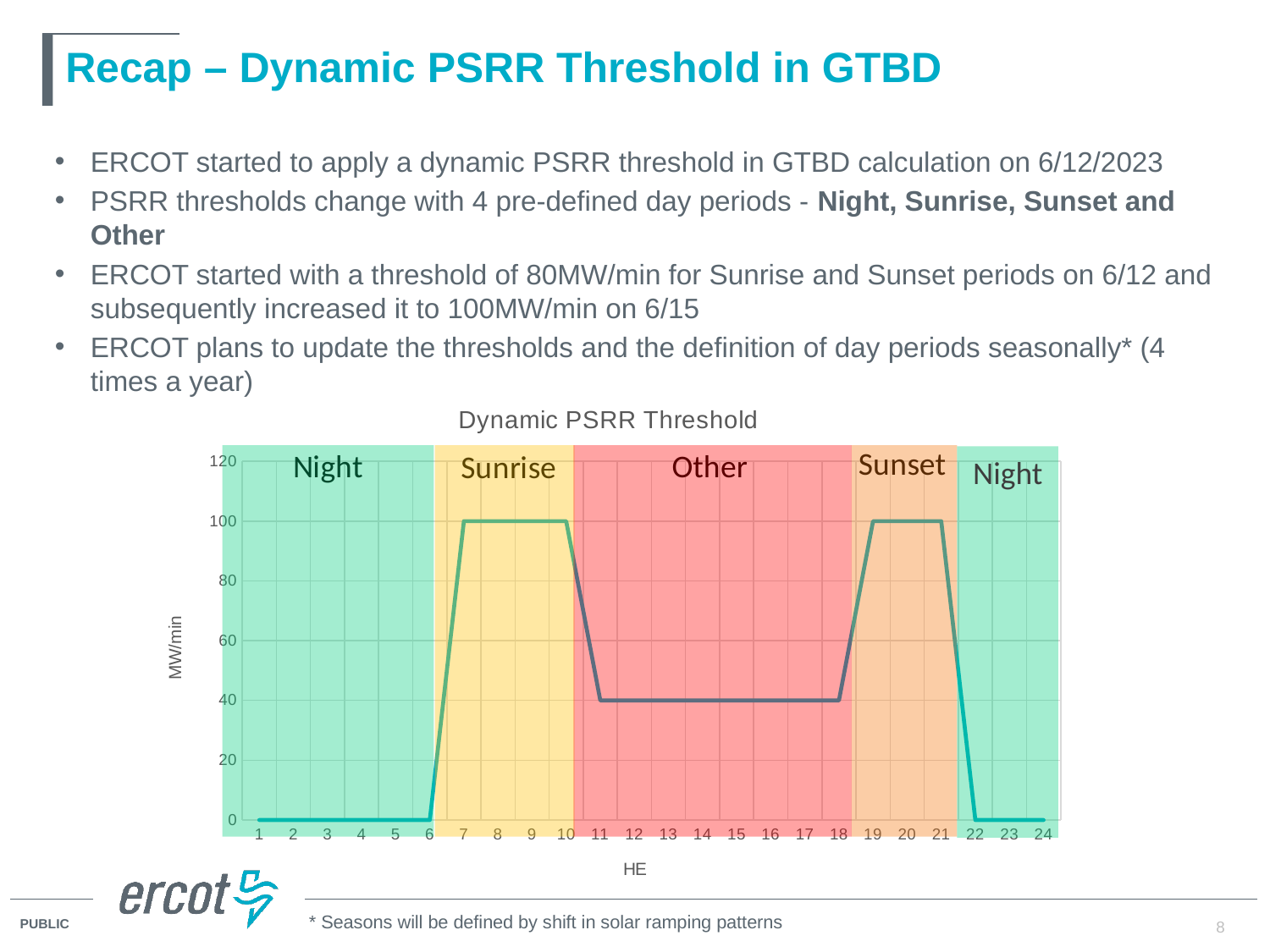
What is the threshold value in MW/min at HE 20? 100 Is the threshold value at HE 12 greater or less than 60? less What is the threshold value in MW/min at HE 8? 100 What kind of chart is shown on the slide? line chart What is the label of the y axis of the chart? MW/min What is the threshold value in MW/min at HE 3? 0 What is the difference in MW/min between the threshold at HE 8 and the threshold at HE 14? 60 What is the title of the chart? Dynamic PSRR Threshold Which is larger, the threshold at HE 9 or the threshold at HE 15? HE 9 How many hour-ending (HE) points are shown on the x axis of the chart? 24 What is the threshold value in MW/min at HE 14? 40 Does the threshold rise or fall between HE 10 and HE 11? fall